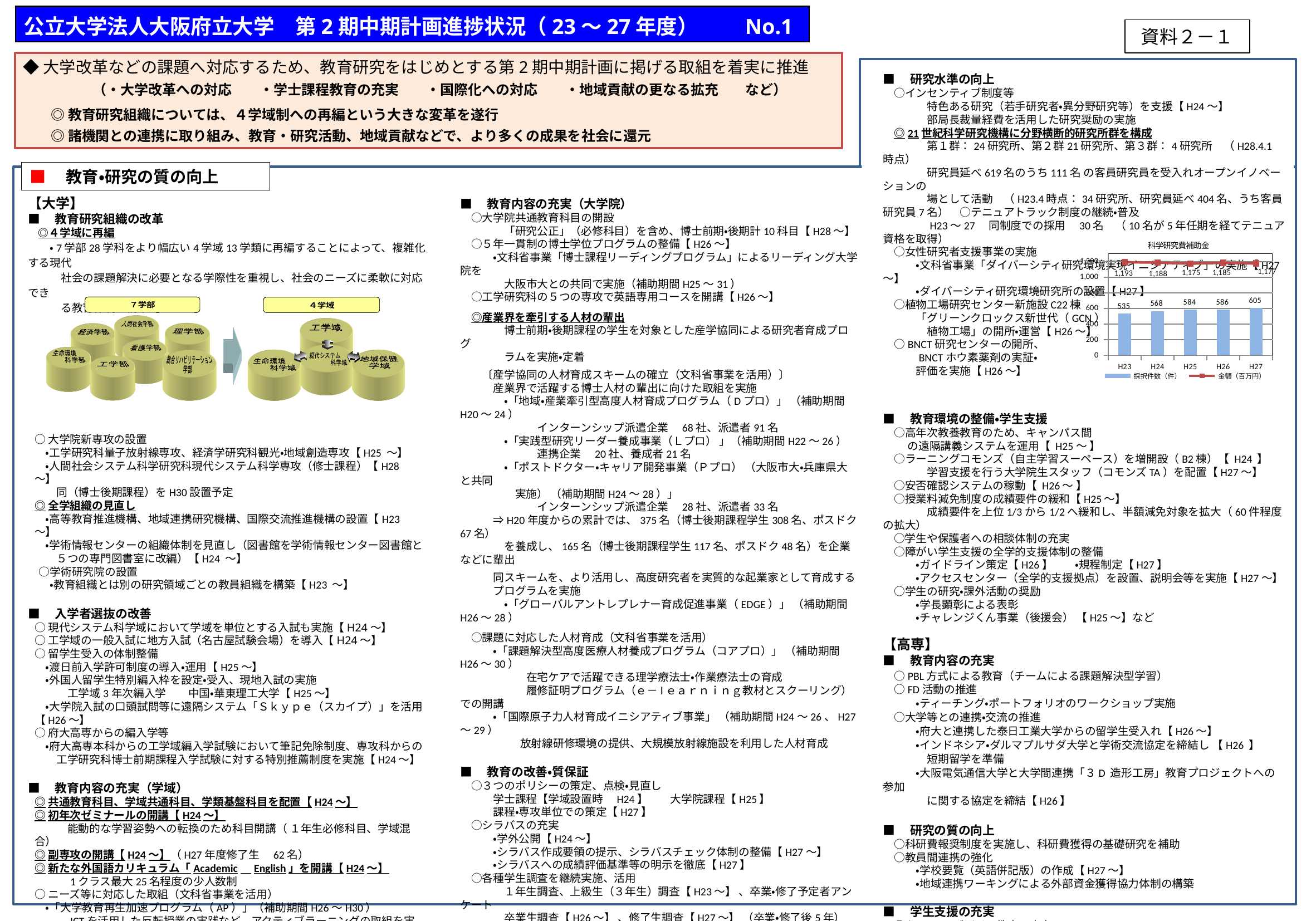
What is the title of the chart on the slide? 科学研究費補助金 In the 科学研究費補助金 chart, what is the 採択件数（件） value for H27? 605 In the 科学研究費補助金 chart, what is the 金額（百万円） value for H23? 1,193 How many series does the legend of the 科学研究費補助金 chart list? 2 In the 科学研究費補助金 chart, which year has the highest 採択件数（件）? H27 In the 科学研究費補助金 chart, does the 採択件数（件） rise or fall from H23 to H27? rise In the 科学研究費補助金 chart, what is the difference in 採択件数（件） between H27 and H23? 70 In the 科学研究費補助金 chart, is the 採択件数（件） larger for H24 or H25? H25 How many years are shown on the x axis of the 科学研究費補助金 chart? 5 In the 科学研究費補助金 chart, what is the 採択件数（件） value for H23? 535 In the 科学研究費補助金 chart, what is the 金額（百万円） value for H25? 1,175 In the 科学研究費補助金 chart, which year has the lowest 採択件数（件）? H23